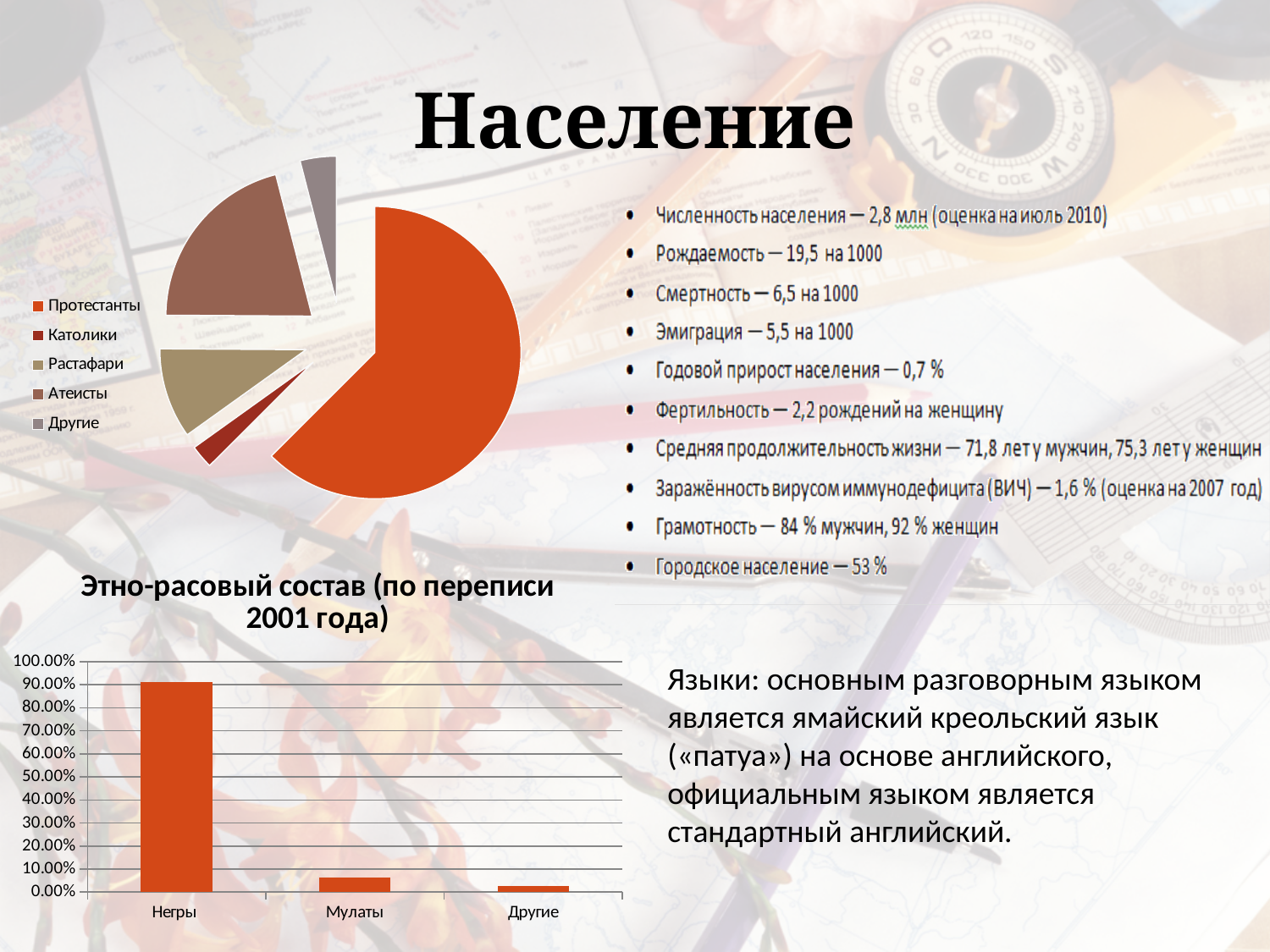
What kind of chart is the chart at the top left of the slide? pie chart What kind of chart is the chart titled "Этно-расовый состав (по переписи 2001 года)"? bar chart In the chart "Этно-расовый состав (по переписи 2001 года)", is the value for Мулаты greater or less than 10.00%? less In the chart "Этно-расовый состав (по переписи 2001 года)", is the value for Негры greater or less than 80.00%? greater In the chart "Этно-расовый состав (по переписи 2001 года)", which category has the highest value? Негры In the pie chart at the top left, which slice is larger: Протестанты or Атеисты? Протестанты How many slices does the pie chart at the top left have? 5 In the pie chart at the top left, which category has the largest slice? Протестанты How many categories are shown on the x axis of the chart "Этно-расовый состав (по переписи 2001 года)"? 3 In the chart "Этно-расовый состав (по переписи 2001 года)", which category has the lowest value? Другие How many entries does the legend of the pie chart at the top left list? 5 In the pie chart at the top left, which slice is larger: Атеисты or Растафари? Атеисты